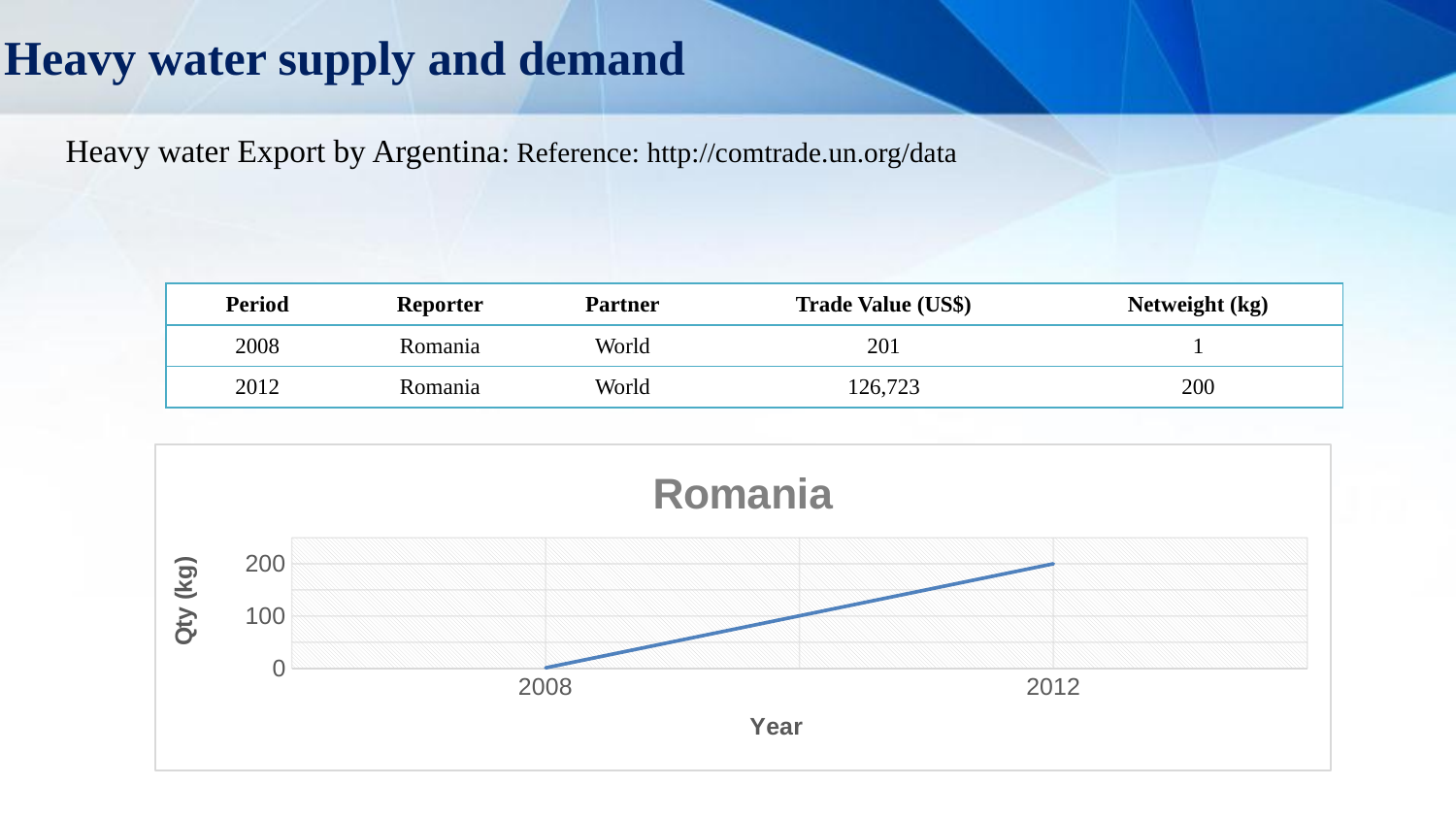
How many data points are plotted on the chart? 2 What is the title of the chart? Romania What is the label of the vertical axis of the chart? Qty (kg) What is the value for 2012 on the chart? 200 Is the value for 2008 on the chart greater or less than 100? less Which year has the larger value on the chart, 2008 or 2012? 2012 Which year has the lowest value on the chart? 2008 Which year has the highest value on the chart? 2012 Does the value rise or fall from 2008 to 2012 on the chart? rise What kind of chart is shown on the slide? line chart